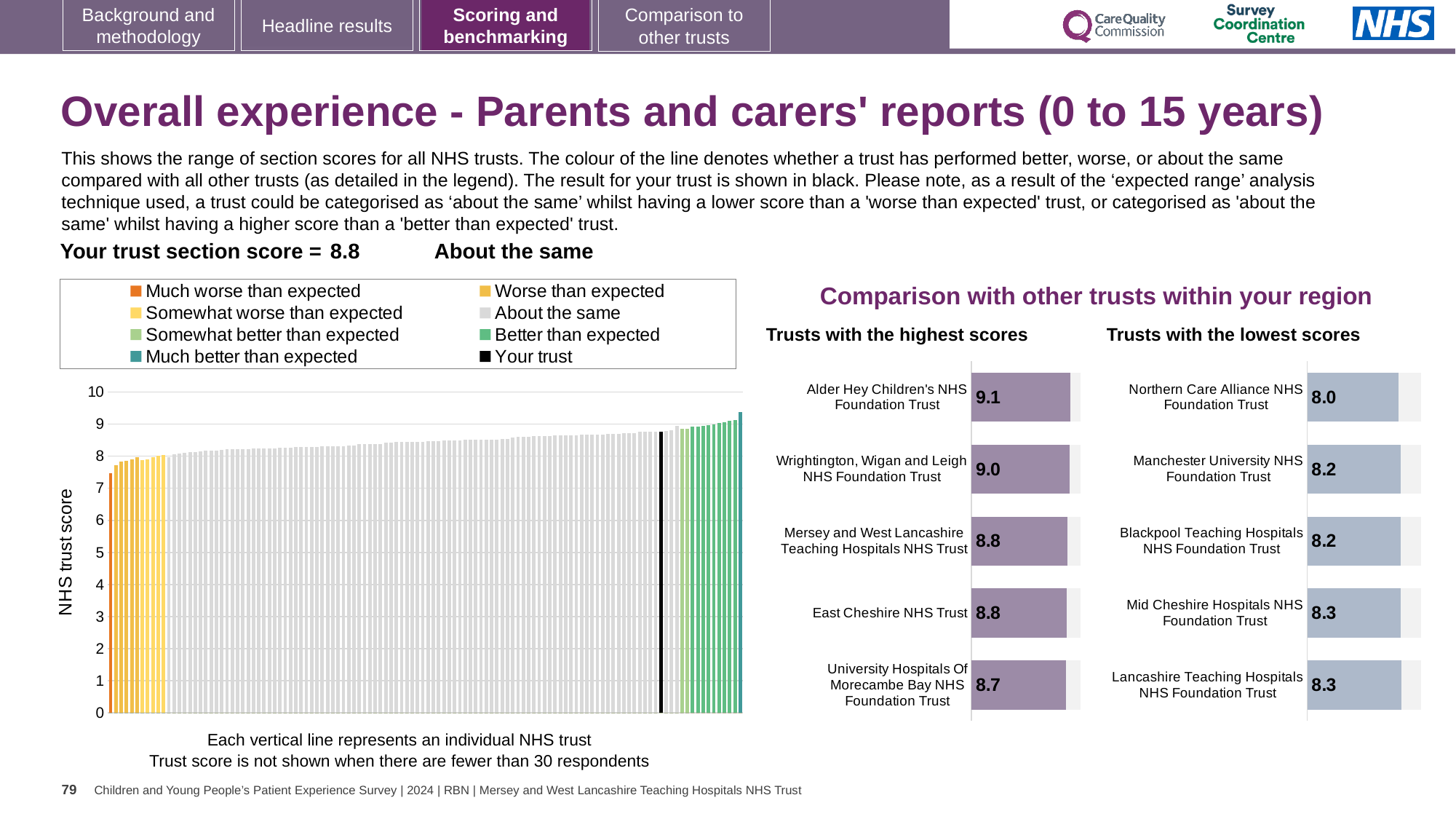
In the 'Trusts with the highest scores' chart, which trust has the highest score? Alder Hey Children's NHS Foundation Trust What kind of chart is the large chart on the left showing NHS trust scores? Bar chart In the 'Trusts with the highest scores' chart, what is the difference between the scores of Alder Hey Children's NHS Foundation Trust and University Hospitals Of Morecambe Bay NHS Foundation Trust? 0.4 In the 'Trusts with the lowest scores' chart, what is the difference between the scores of Lancashire Teaching Hospitals NHS Foundation Trust and Northern Care Alliance NHS Foundation Trust? 0.3 In the 'Trusts with the highest scores' chart, what is the score for Alder Hey Children's NHS Foundation Trust? 9.1 How many entries does the legend of the left-hand NHS trust score chart list? 8 How many trusts are shown in the 'Trusts with the lowest scores' chart? 5 In the left-hand NHS trust score chart, do the bar values rise or fall from left to right? Rise In the 'Trusts with the lowest scores' chart, which trust has the lowest score? Northern Care Alliance NHS Foundation Trust In the 'Trusts with the lowest scores' chart, what is the score for Northern Care Alliance NHS Foundation Trust? 8.0 In the 'Trusts with the lowest scores' chart, which has the higher score: Mid Cheshire Hospitals NHS Foundation Trust or Manchester University NHS Foundation Trust? Mid Cheshire Hospitals NHS Foundation Trust In the left-hand NHS trust score chart, is the value of the leftmost (orange) bar greater or less than 8? less